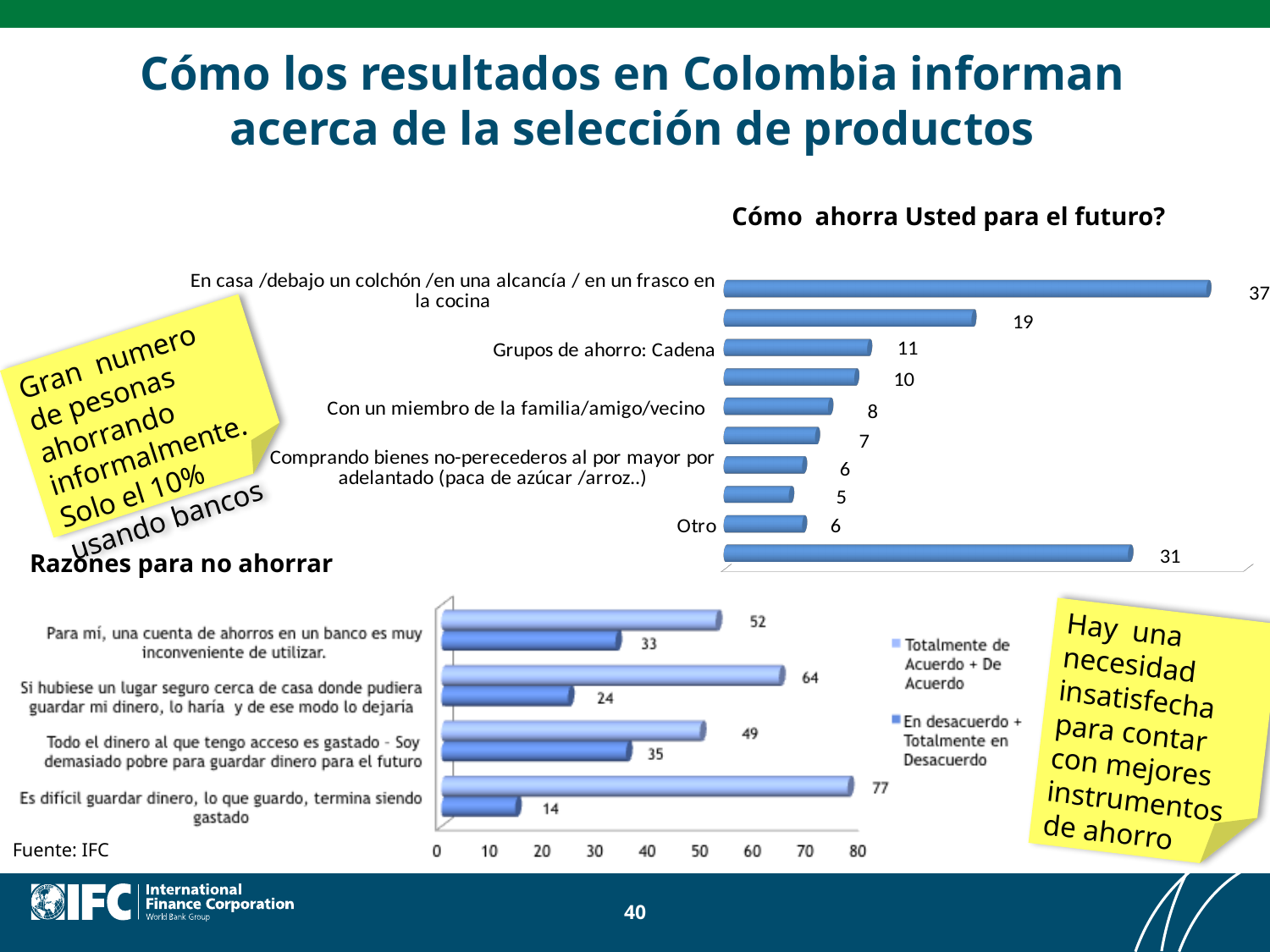
In the chart 'Cómo ahorra Usted para el futuro?', what is the difference between the values for 'En casa /debajo un colchón /en una alcancía / en un frasco en la cocina' and 'Grupos de ahorro: Cadena'? 26 In the chart 'Cómo ahorra Usted para el futuro?', what is the value for 'Con un miembro de la familia/amigo/vecino'? 8 In the chart 'Cómo ahorra Usted para el futuro?', what is the value for 'Otro'? 6 In the chart 'Cómo ahorra Usted para el futuro?', which labelled category has the highest value? En casa /debajo un colchón /en una alcancía / en un frasco en la cocina In the chart 'Razones para no ahorrar', which category has the highest 'Totalmente de Acuerdo + De Acuerdo' value? Es difícil guardar dinero, lo que guardo, termina siendo gastado In the chart 'Cómo ahorra Usted para el futuro?', what is the value for 'En casa /debajo un colchón /en una alcancía / en un frasco en la cocina'? 37 In the chart 'Razones para no ahorrar', what is the 'Totalmente de Acuerdo + De Acuerdo' value for 'Es difícil guardar dinero, lo que guardo, termina siendo gastado'? 77 In the chart 'Razones para no ahorrar', how many series does the legend list? 2 In the chart 'Cómo ahorra Usted para el futuro?', how many bars are plotted? 10 In the chart 'Cómo ahorra Usted para el futuro?', what is the value for 'Grupos de ahorro: Cadena'? 11 In the chart 'Razones para no ahorrar', what is the 'En desacuerdo + Totalmente en Desacuerdo' value for 'Si hubiese un lugar seguro cerca de casa donde pudiera guardar mi dinero, lo haría y de ese modo lo dejaría'? 24 What kind of chart is 'Razones para no ahorrar'? Bar chart